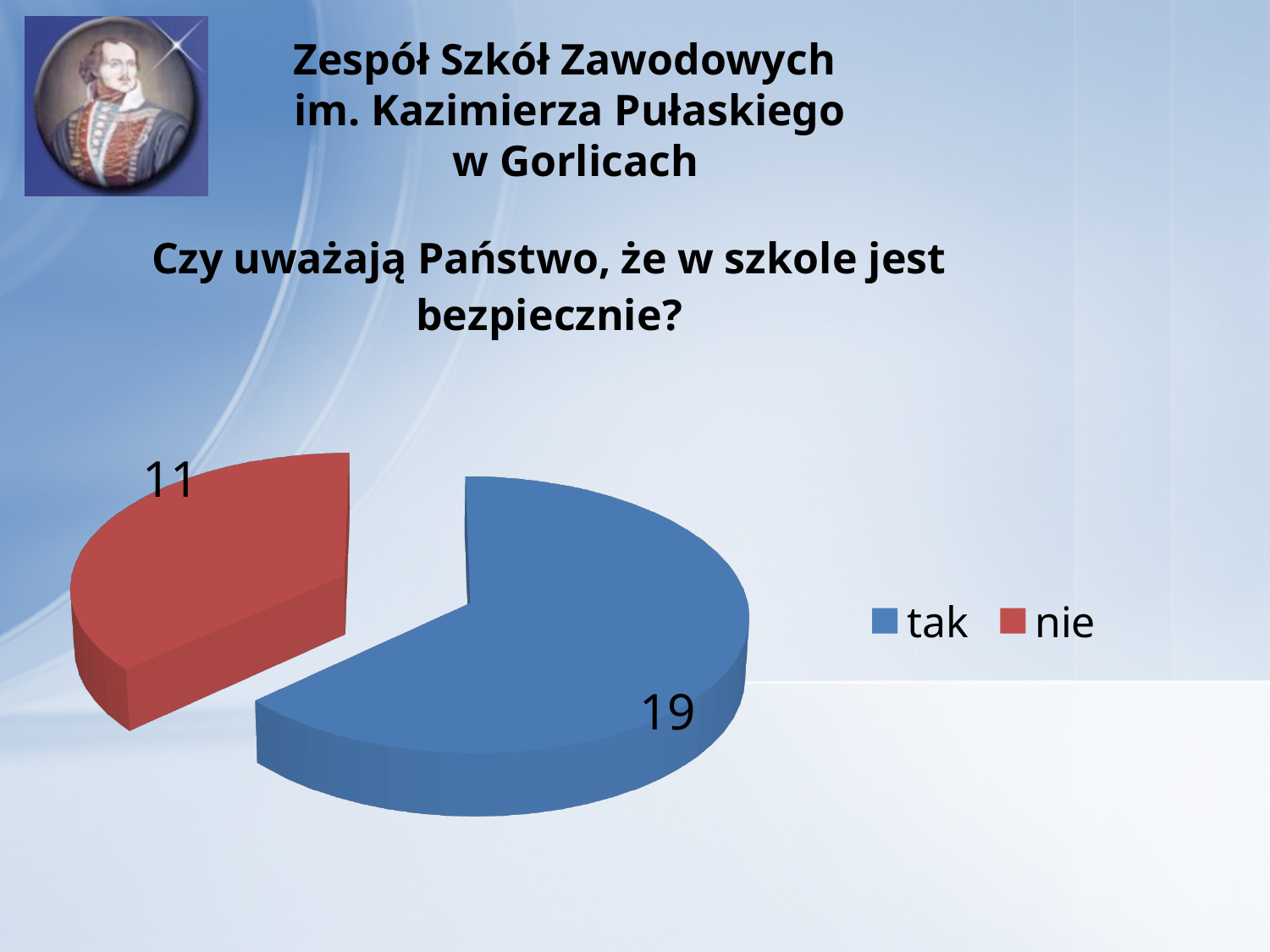
What colour is the "nie" slice? red What question does the chart's title ask? Czy uważają Państwo, że w szkole jest bezpiecznie? Which is larger, "tak" or "nie"? tak What value is shown for the "tak" slice? 19 What is the total of all slices in the pie chart? 30 How many slices does the pie chart have? 2 Which slice is the smallest? nie What is the difference between the "tak" and "nie" values? 8 How many entries does the legend list? 2 What value is shown for the "nie" slice? 11 Which slice is the largest? tak What kind of chart is shown on the slide? pie chart